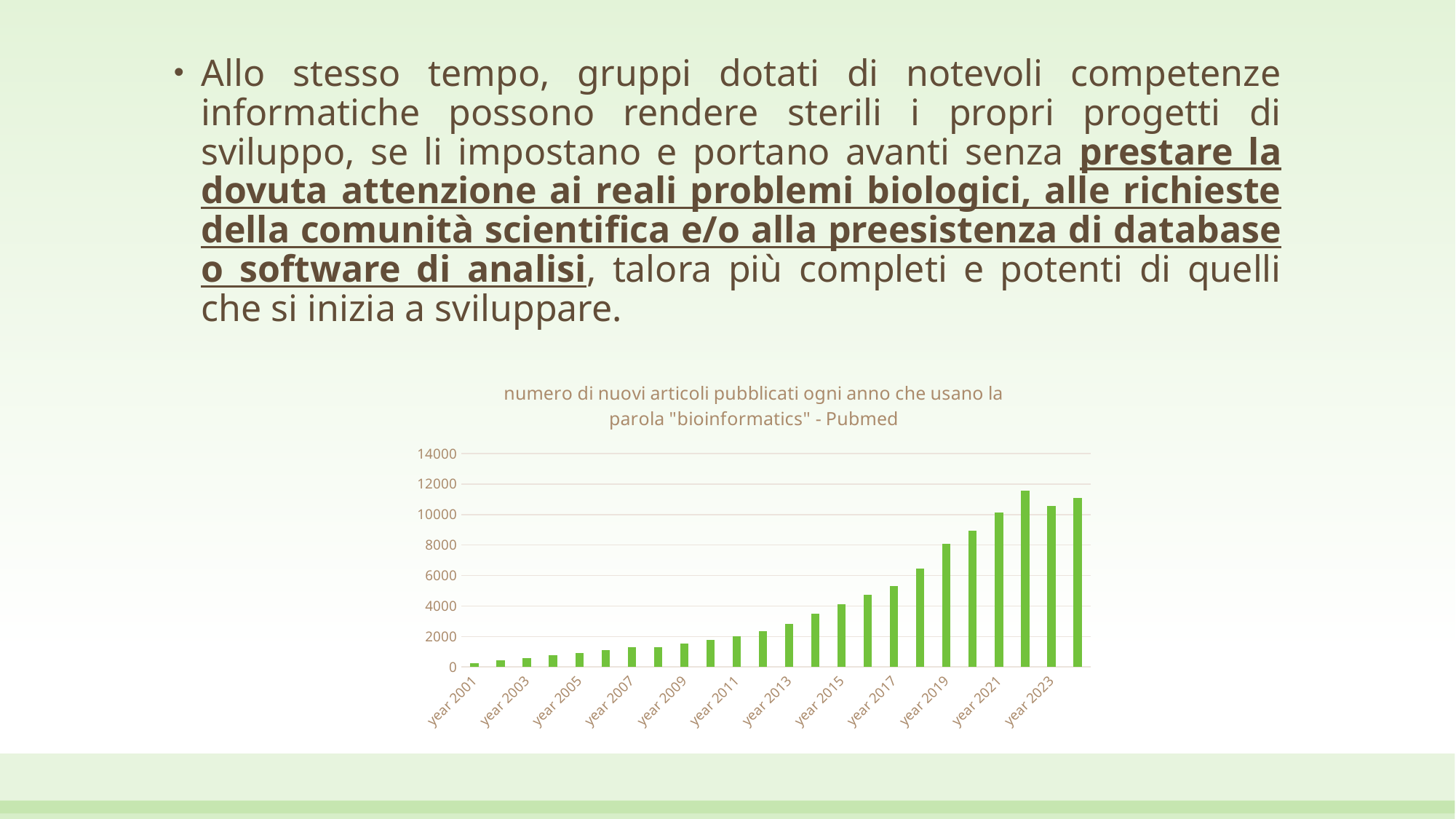
Is the value for year 2017 greater or less than 4000? greater Do the values generally rise or fall from year 2001 to year 2023? rise Which year has the highest value in the chart? year 2022 What is the title of the chart? numero di nuovi articoli pubblicati ogni anno che usano la parola "bioinformatics" - Pubmed What kind of chart is shown on the slide? bar chart Is the value for year 2023 greater or less than 10000? greater Which year has the lowest value in the chart? year 2001 What colour are the bars in the chart? green Is the value for year 2001 greater or less than 2000? less Which is larger, the value for year 2001 or the value for year 2023? year 2023